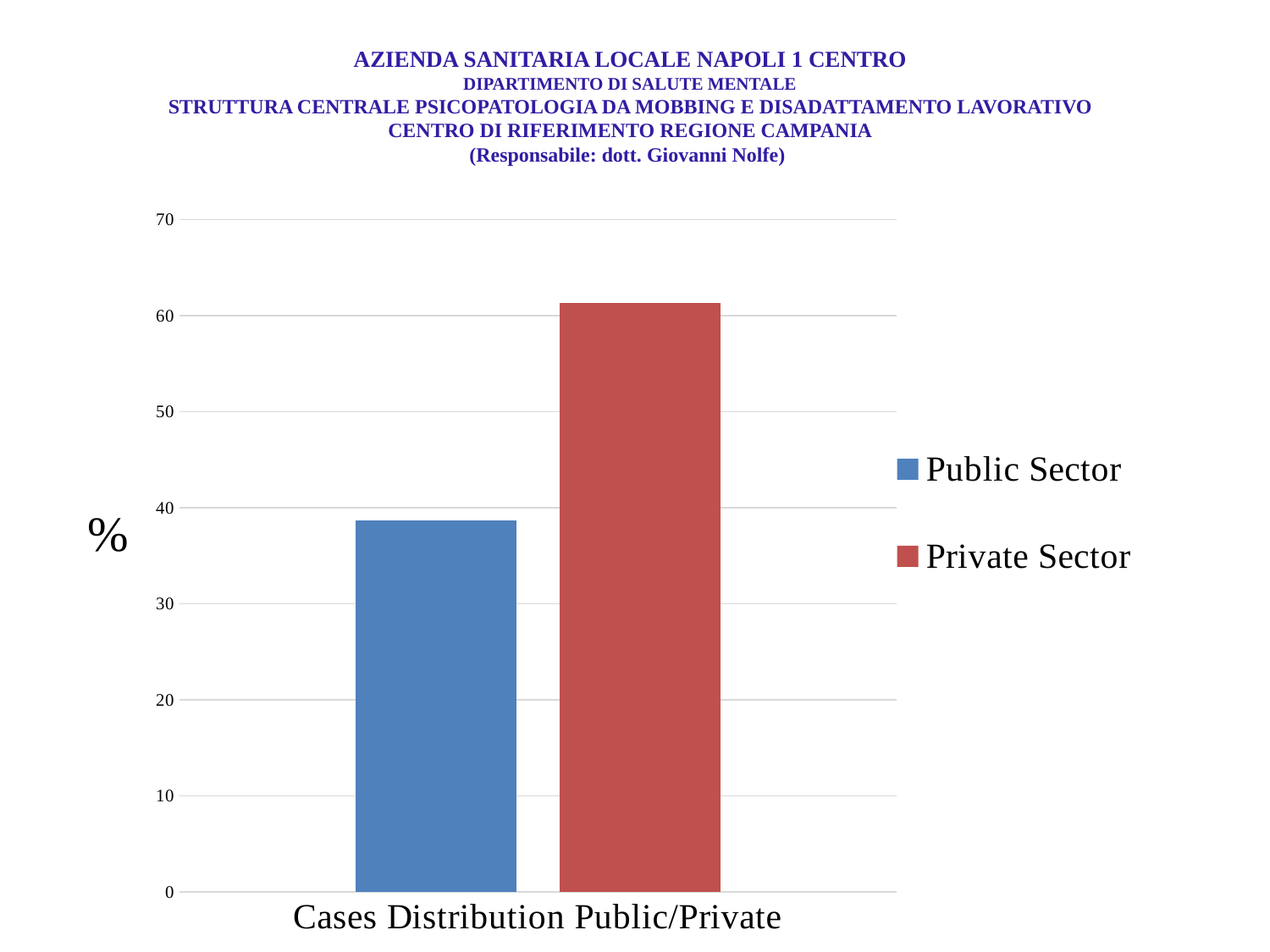
Is the value for Public Sector greater or less than 40? less Is the value for Public Sector greater or less than 30? greater Which is larger, the value for Public Sector or the value for Private Sector? Private Sector Which series has the highest bar? Private Sector What colour is the Private Sector bar? red How many categories are shown on the x axis? 1 How many series does the legend list? 2 What kind of chart is shown on the slide? bar chart Is the value for Private Sector greater or less than 70? less What is the label on the vertical axis? % Which series has the lowest bar? Public Sector